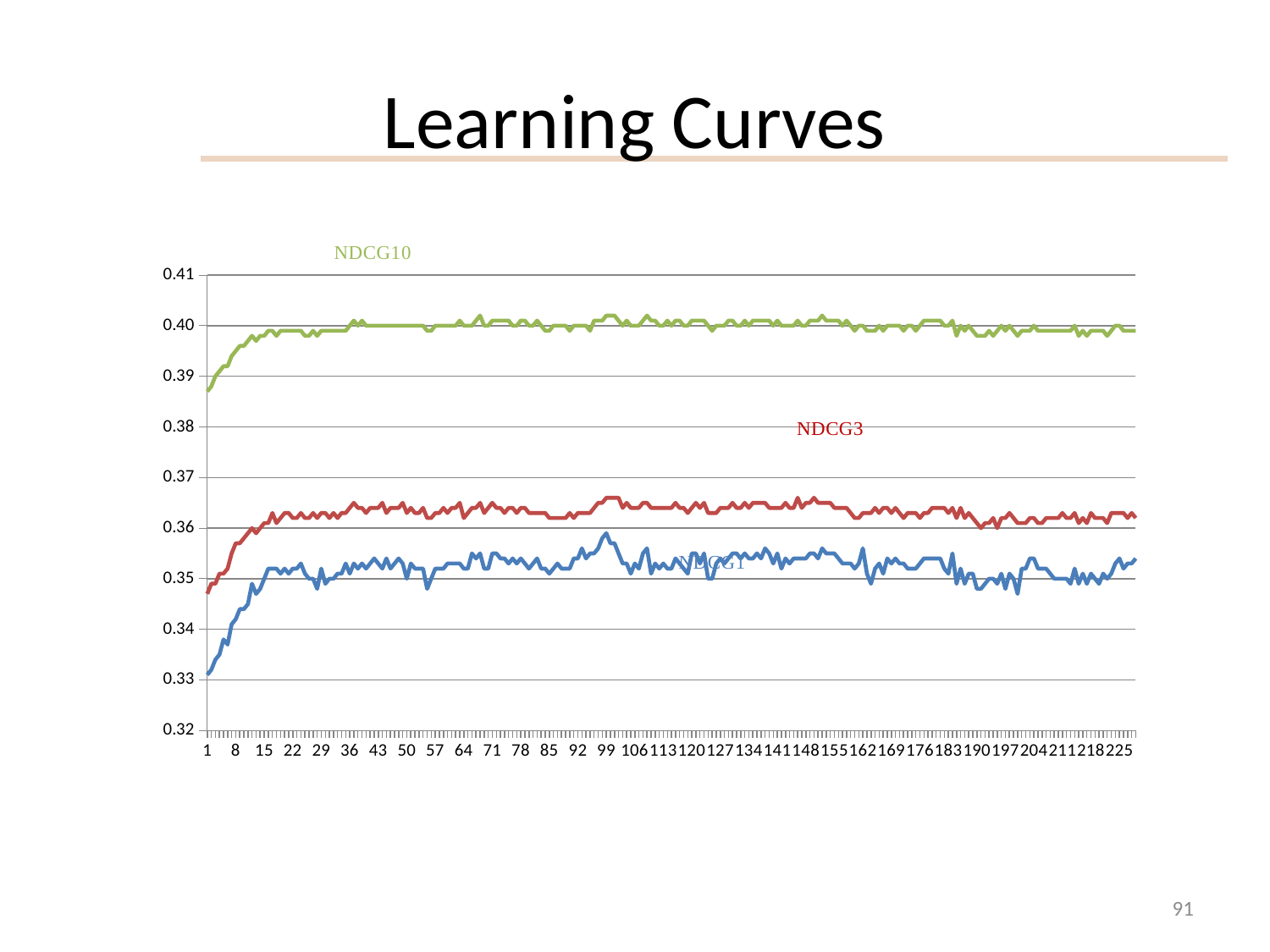
Do the NDCG1 values rise or fall over the first 15 points on the x axis? rise Which series has the highest values throughout the chart? NDCG10 Is the value of NDCG1 at x = 1 greater or less than 0.34? less How many series are plotted on the chart? 3 Which series has the lowest values throughout the chart? NDCG1 What kind of chart is shown on the slide? line chart Is the value of NDCG10 at x = 1 greater or less than 0.39? less What is the title of the slide containing the chart? Learning Curves Which series is larger at x = 99, NDCG3 or NDCG1? NDCG3 Is the value of NDCG3 at x = 1 greater or less than 0.35? less